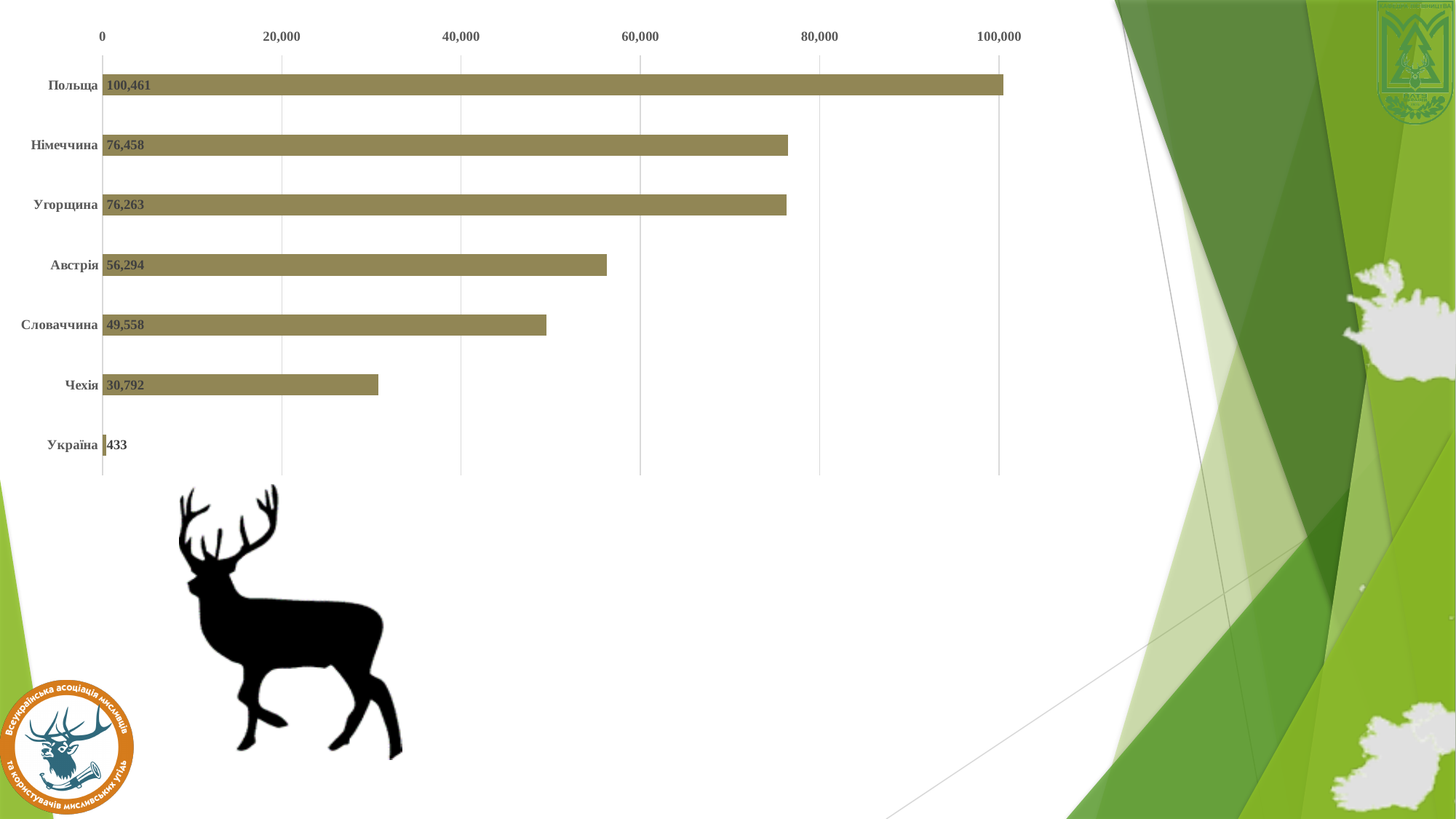
What is the value for Чехія? 30,792 Which is larger, the value for Словаччина or the value for Чехія? Словаччина Which country has the lowest value? Україна What kind of chart is shown on the slide? bar chart Which country has the highest value? Польща What is the difference between the values for Австрія and Словаччина? 6,736 Is the value for Угорщина greater or less than 80,000? less What is the value for Австрія? 56,294 What is the value for Польща? 100,461 What is the difference between the values for Польща and Німеччина? 24,003 How many countries are shown in the chart? 7 What is the value for Україна? 433